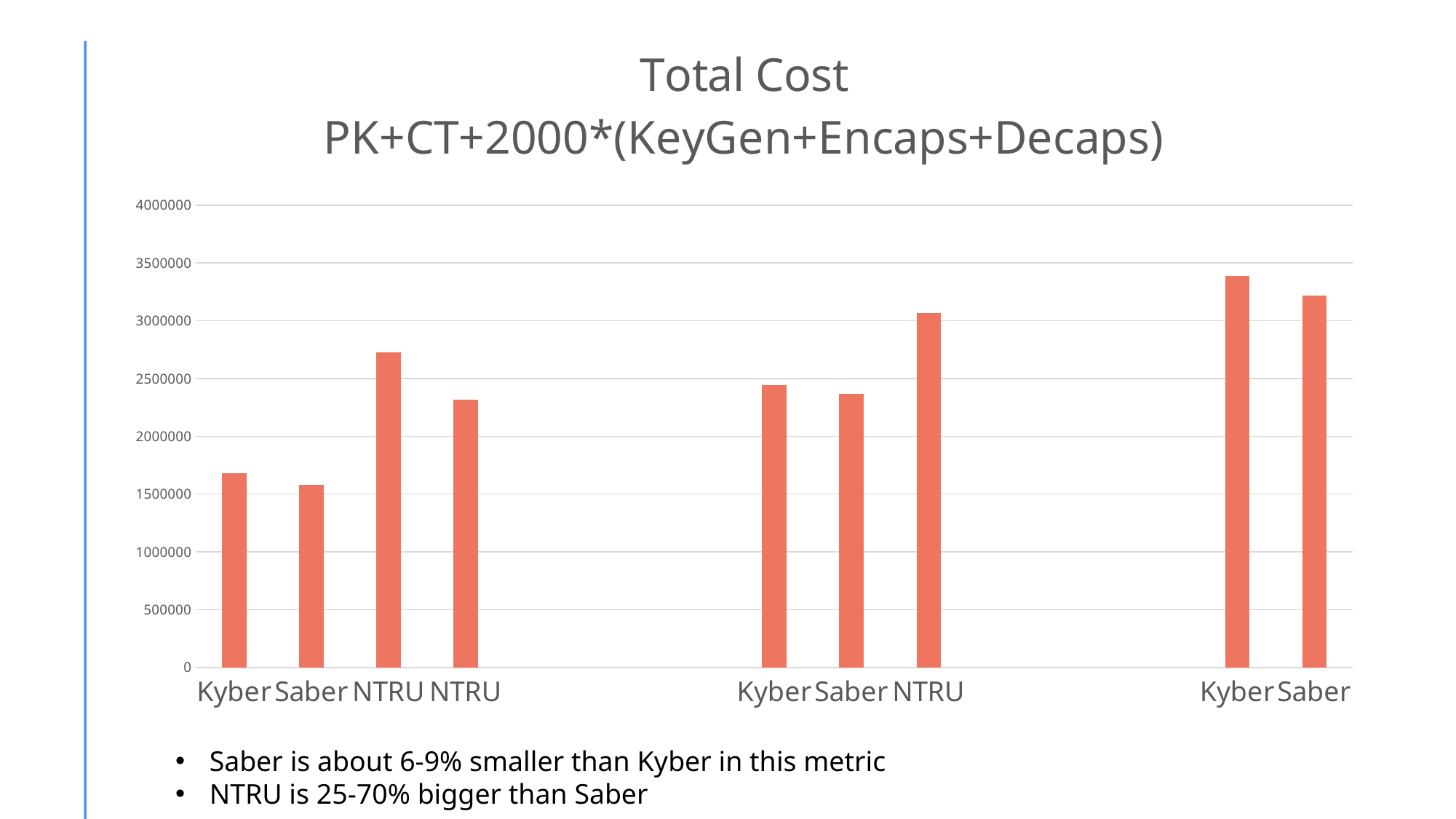
How many bars are plotted in the chart? 9 Is the value for NTRU in the middle group greater or less than 3000000? greater What is the title of the chart? Total Cost PK+CT+2000*(KeyGen+Encaps+Decaps) Which bar is the highest in the chart? Kyber in the rightmost group Is the value for the first NTRU bar in the leftmost group greater or less than 2500000? greater Is the value for Saber in the rightmost group greater or less than 3000000? greater Which bar is the lowest in the chart? Saber in the leftmost group In the rightmost group, which is larger, Kyber or Saber? Kyber What kind of chart is shown on the slide? bar chart In the leftmost group, which of the two NTRU bars is larger, the first or the second? the first